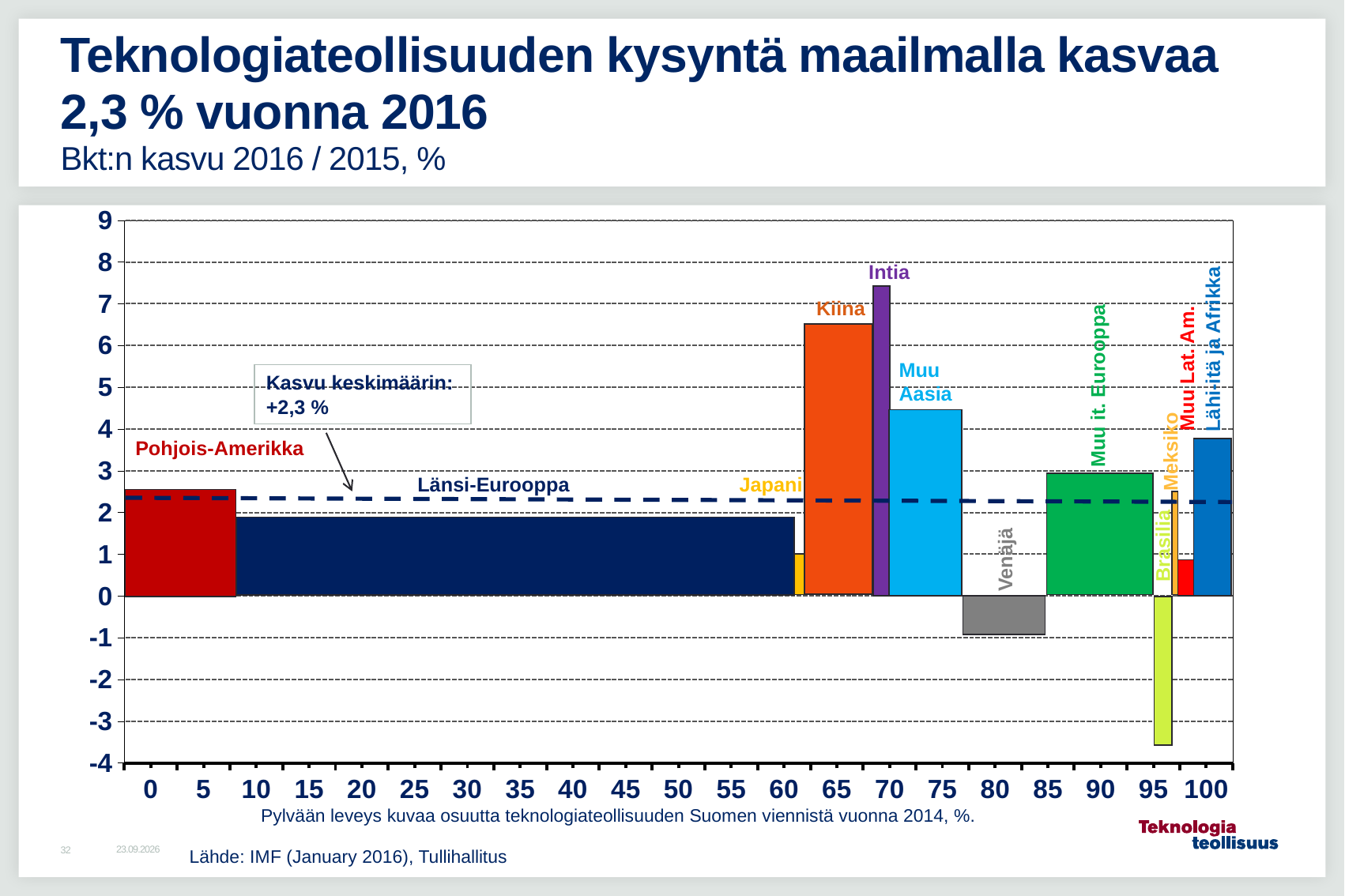
According to the note under the chart, what does the width of each bar represent? Share of Finland's technology industry exports in 2014, % Is the value for Kiina greater or less than 6? greater What is the average growth (Kasvu keskimäärin) shown in the chart annotation? +2,3 % Is the value for Lähi-itä ja Afrikka greater or less than 3? greater Which region has the lowest GDP growth in the chart? Brasilia Which has the larger value, Kiina or Muu Aasia? Kiina Is the value for Intia greater or less than 7? greater Which has the larger value, Venäjä or Brasilia? Venäjä Which region has the highest GDP growth in the chart? Intia What kind of chart is shown on the slide? bar chart